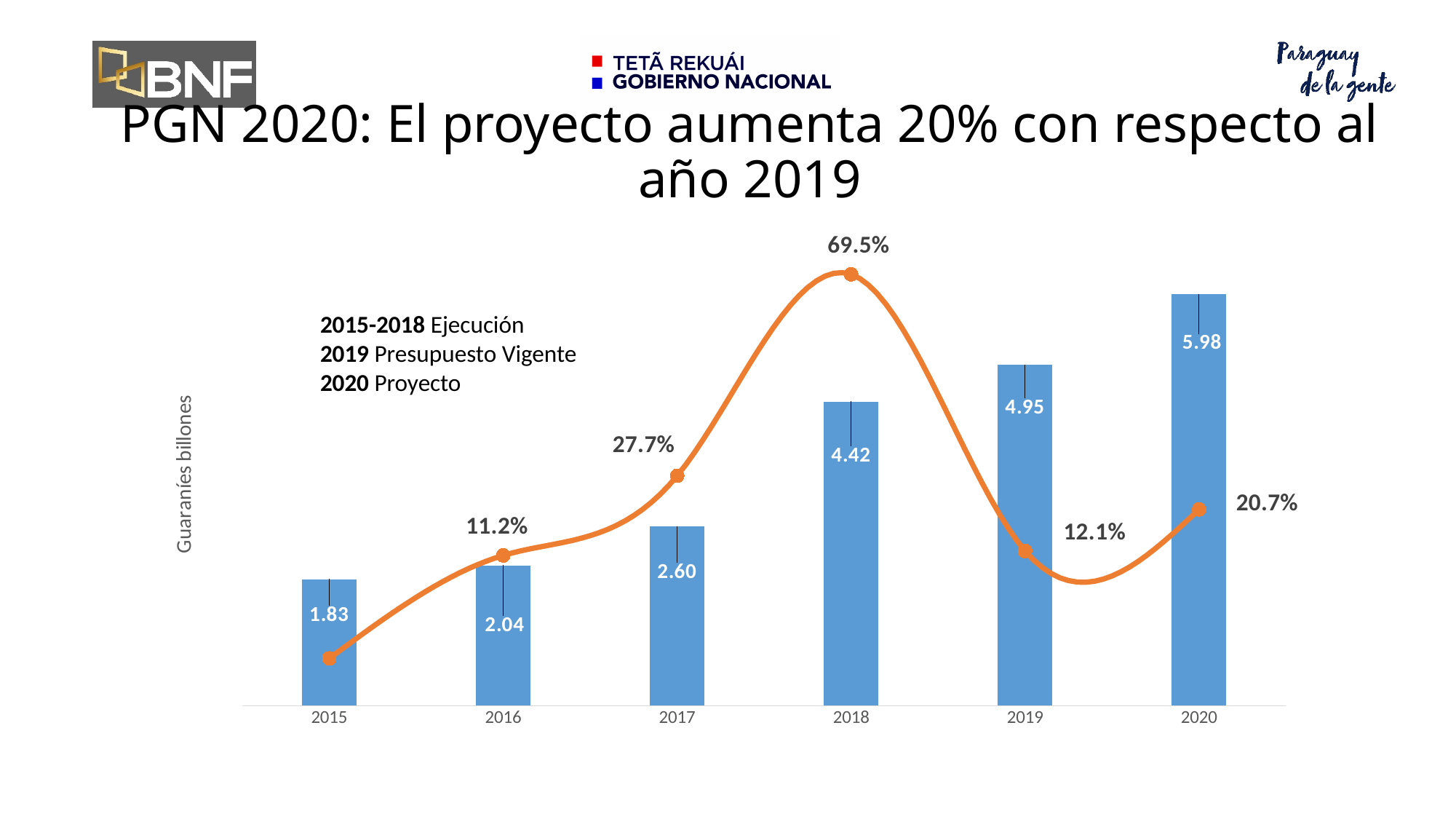
What is the bar value for 2018? 4.42 What percentage does the line show for 2019? 12.1% How many years are shown on the x axis? 6 Which year has the highest percentage on the line? 2018 What percentage does the line show for 2018? 69.5% What is the difference between the bar values for 2020 and 2019? 1.03 What is the bar value for 2020? 5.98 Which year has the highest bar value? 2020 Which is larger, the bar value for 2017 or for 2016? 2017 Which year has the lowest bar value? 2015 Do the bar values rise or fall from 2015 to 2020? rise What is the label on the vertical axis? Guaraníes billones